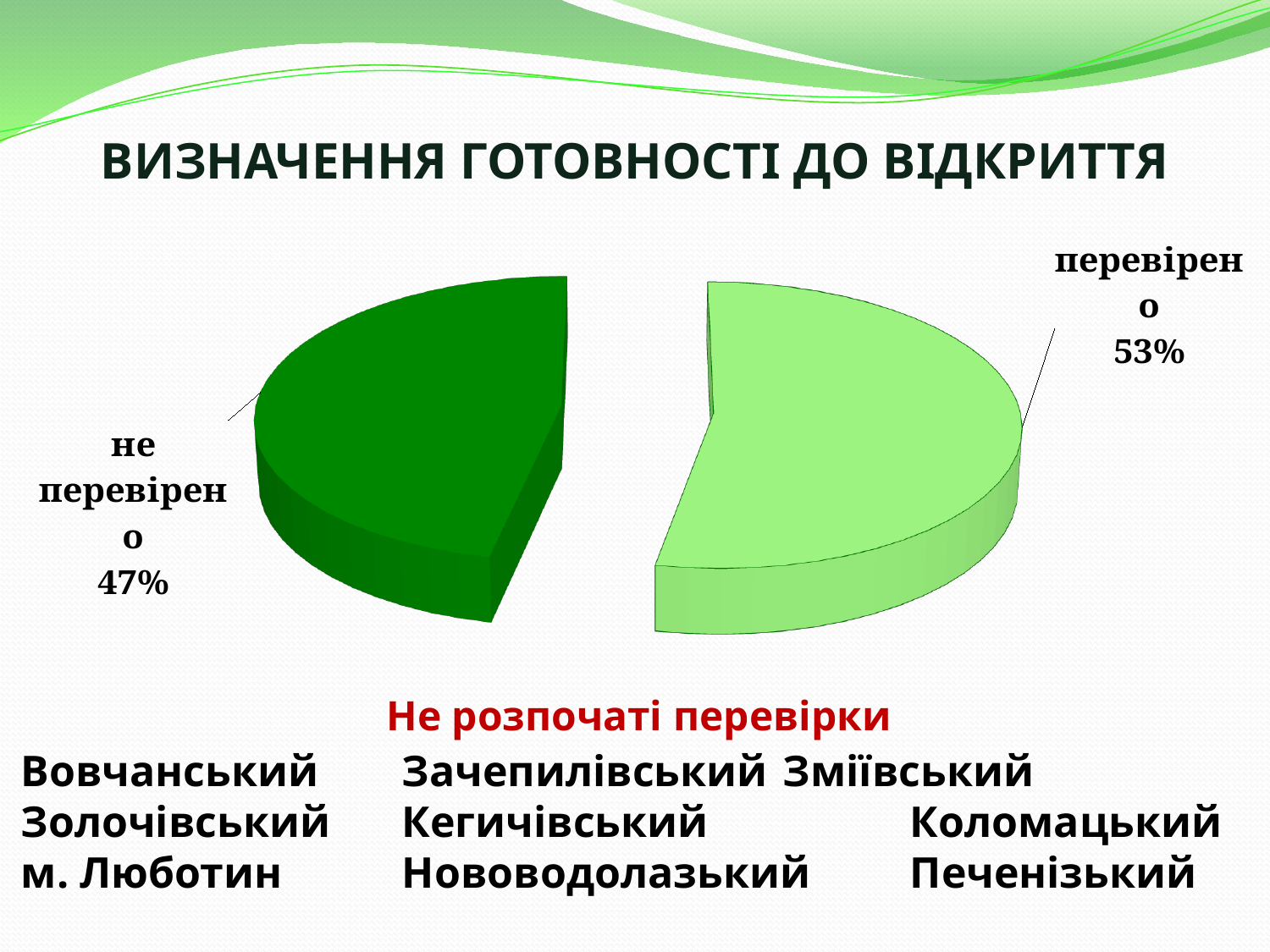
By how many percentage points does the "перевірено" slice exceed the "не перевірено" slice? 6 Which slice of the pie is the largest? перевірено What is the title of the slide above the pie chart? ВИЗНАЧЕННЯ ГОТОВНОСТІ ДО ВІДКРИТТЯ Is the share for "не перевірено" greater or less than 50%? less Which slice of the pie is the smallest? не перевірено What share of the pie is labelled "перевірено"? 53% Is the share for "перевірено" greater or less than 50%? greater What kind of chart is shown on the slide? pie chart What share of the pie is labelled "не перевірено"? 47% How many slices does the pie chart have? 2 Which slice of the pie is drawn in the darker green colour? не перевірено Which is larger: the "перевірено" slice or the "не перевірено" slice? перевірено